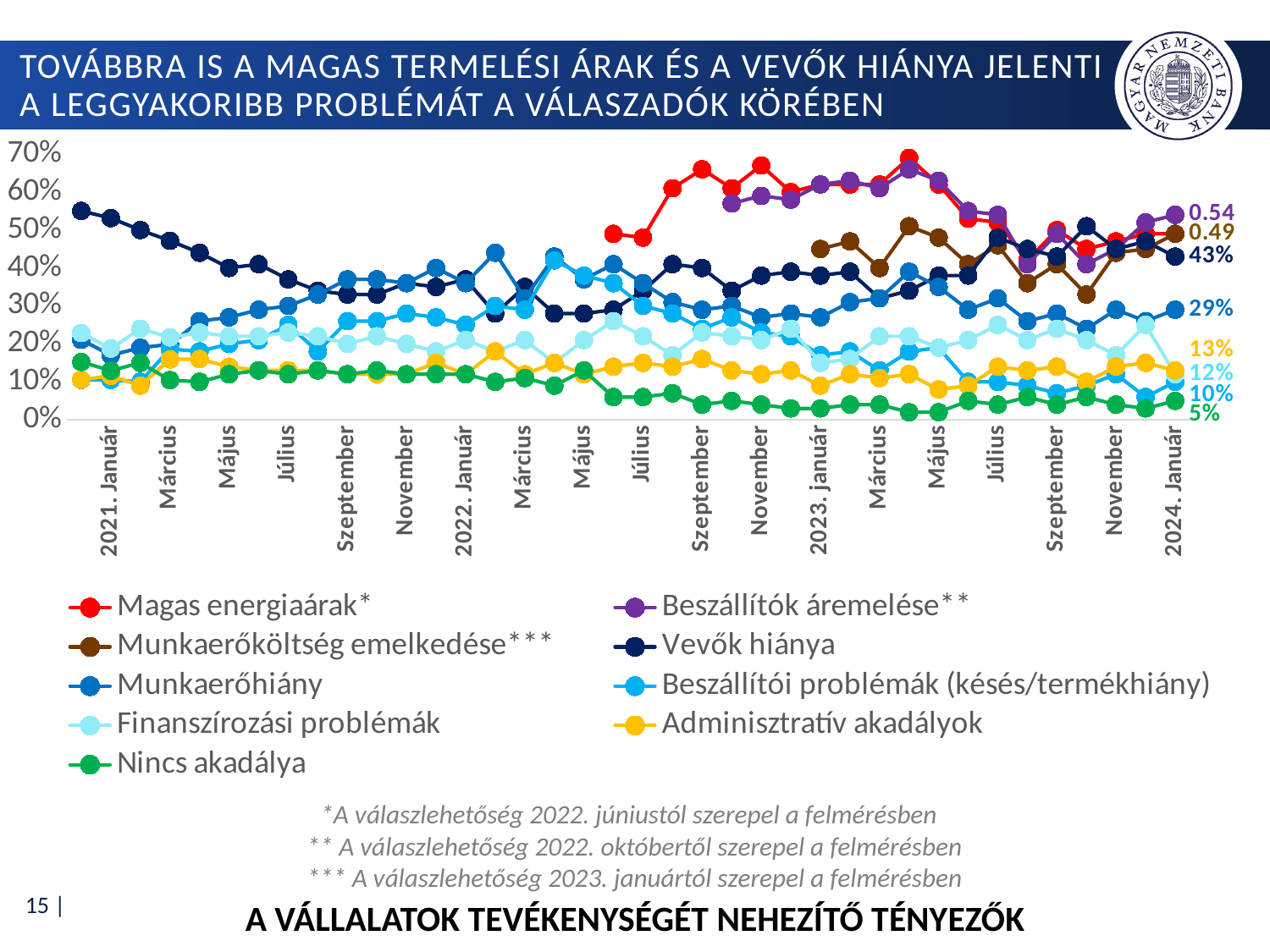
What is the value for Beszállítók áremelése at 2024. január? 0.54 How many series does the legend list? 9 What is the value for Munkaerőhiány at 2024. január? 29% What is the difference between Vevők hiánya and Munkaerőhiány at 2024. január? 14 percentage points Which series has the lowest value at 2024. január? Nincs akadálya Does the Vevők hiánya series rise or fall between 2021. január and 2022. május? fall Which series has the highest value at 2024. január? Beszállítók áremelése What is the value for Vevők hiánya at 2024. január? 43% What type of chart is shown on the slide? line chart What is the value for Adminisztratív akadályok at 2024. január? 13% What is the value for Nincs akadálya at 2024. január? 5% Is the value for Vevők hiánya at 2021. január greater or less than 50%? greater